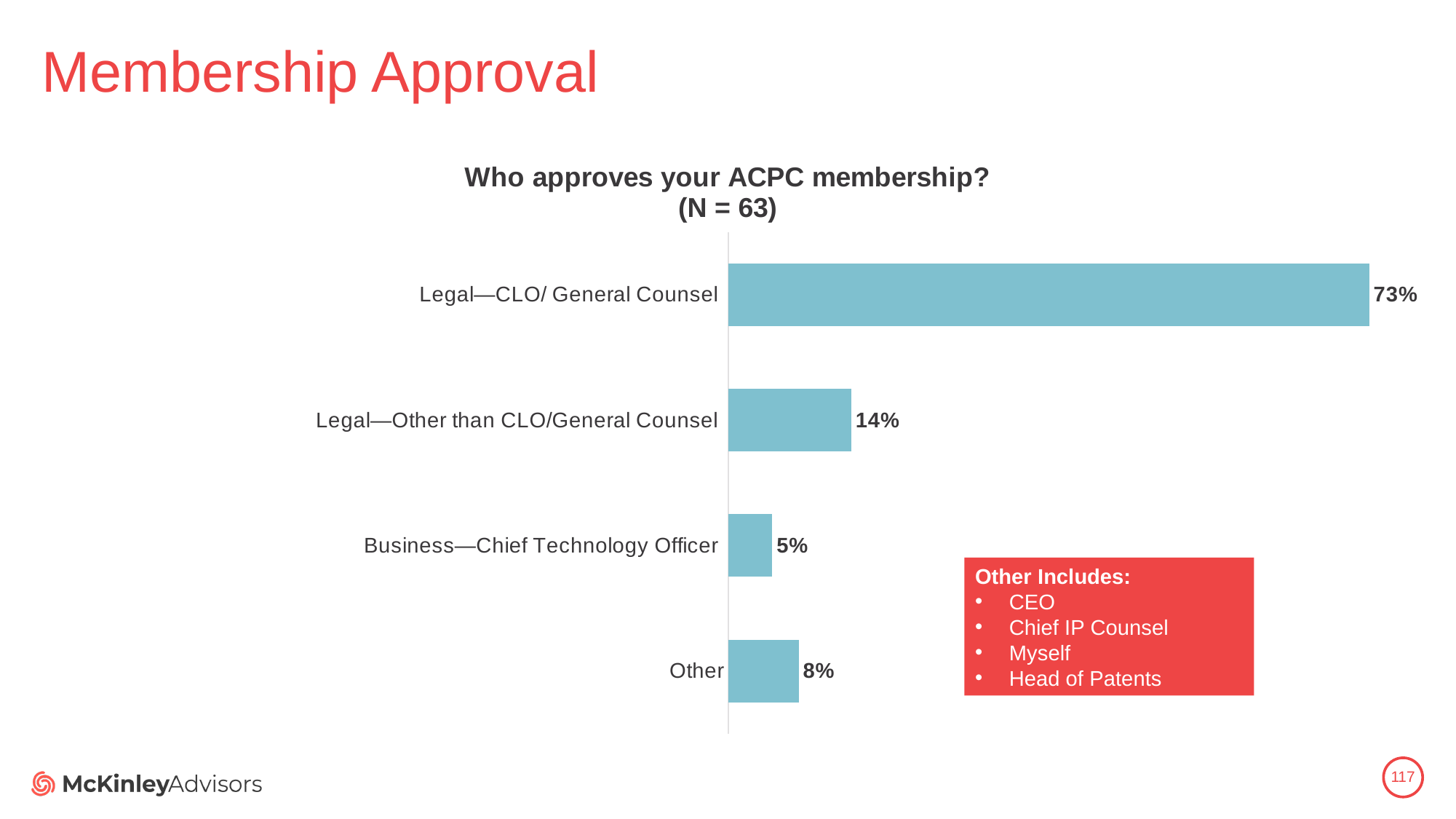
What is the value for Business—Chief Technology Officer? 5% What is the difference in percentage points between Legal—CLO/ General Counsel and Legal—Other than CLO/General Counsel? 59 percentage points Which category has the lowest value? Business—Chief Technology Officer What is the title of the chart? Who approves your ACPC membership? (N = 63) What percentage of respondents said Legal—CLO/ General Counsel approves their ACPC membership? 73% What is the value for the Other category? 8% What is the value for Legal—Other than CLO/General Counsel? 14% What is the sample size (N) stated in the chart title? 63 Which category has the highest value? Legal—CLO/ General Counsel What kind of chart is shown on the slide? Bar chart How many categories are shown in the chart? 4 Which is larger, the value for Other or the value for Business—Chief Technology Officer? Other